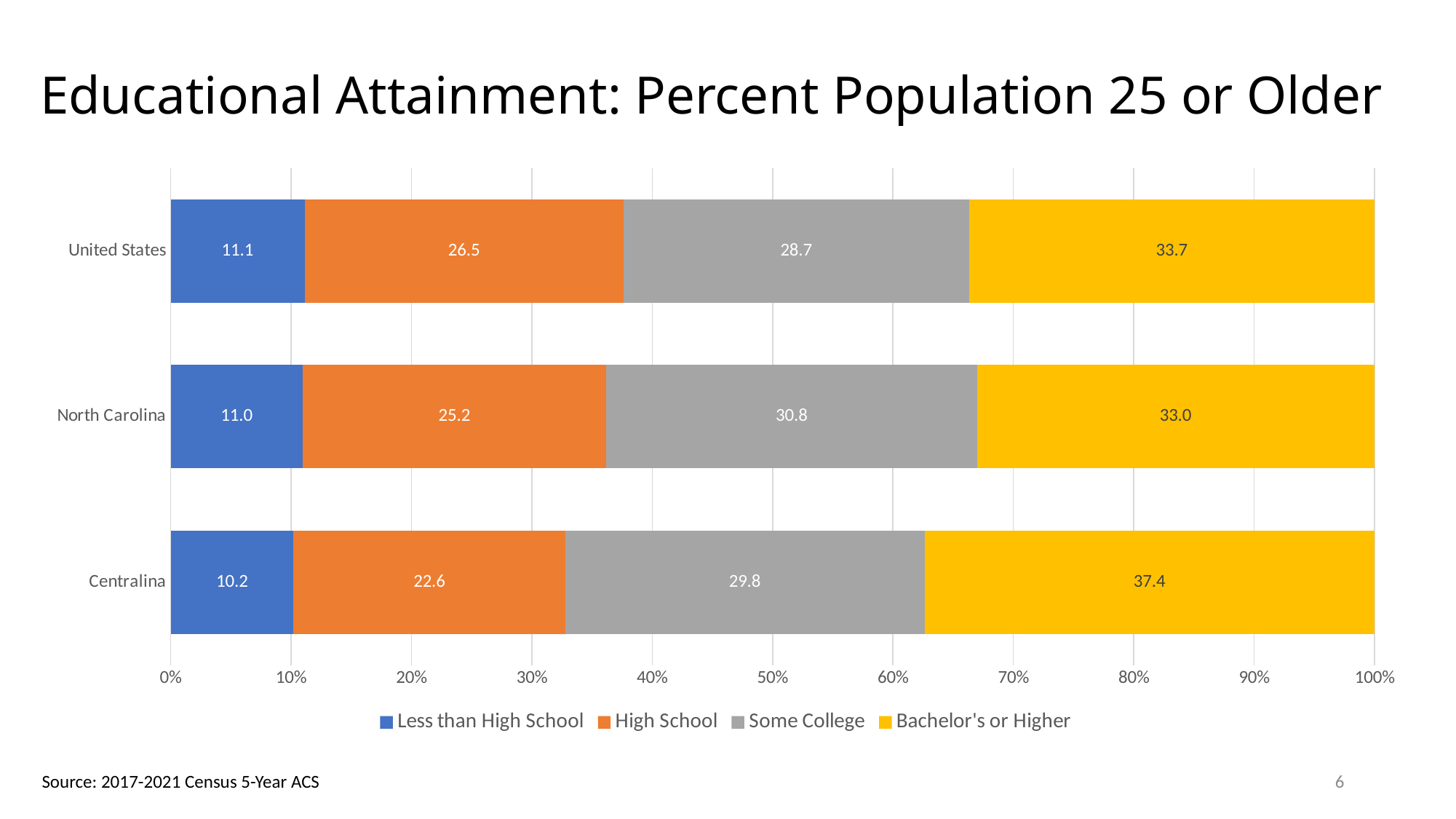
How many regions are shown on the chart? 3 What kind of chart is shown on the slide? Stacked bar chart What is the total of the stacked bar for North Carolina? 100.0 Which colour represents Some College in the chart? Gray Which region has the highest Bachelor's or Higher value? Centralina What is the difference between the Bachelor's or Higher values for Centralina and the United States? 3.7 What is the Bachelor's or Higher value for Centralina? 37.4 How many series does the legend list? 4 What is the Some College value for North Carolina? 30.8 What is the High School value for the United States? 26.5 Which is larger, the High School value for North Carolina or for Centralina? North Carolina Which region has the lowest Less than High School value? Centralina